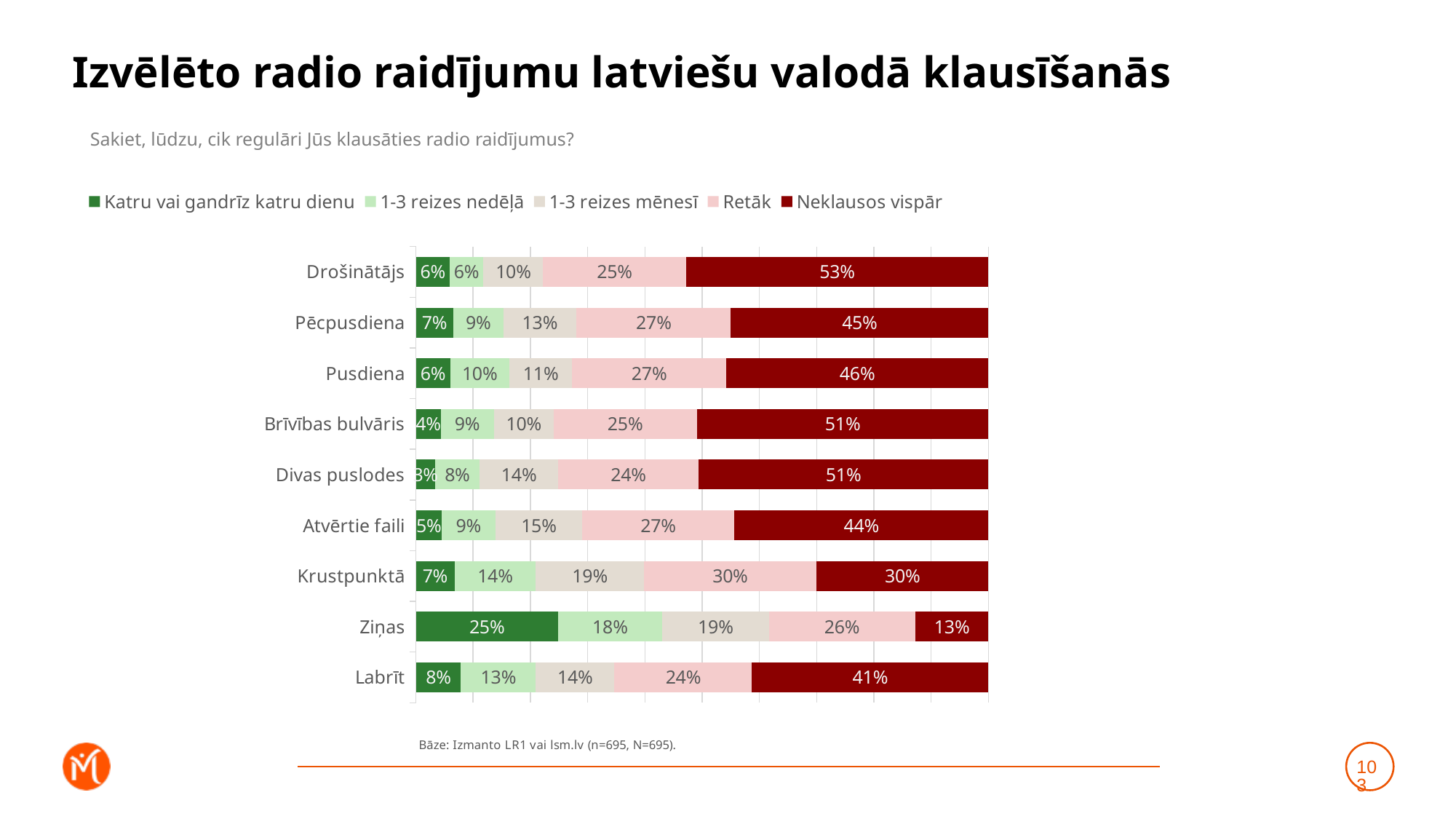
What is the difference between the 'Retāk' values for Krustpunktā and Labrīt? 6% What is the 'Katru vai gandrīz katru dienu' value for Ziņas? 25% What is the 'Neklausos vispār' value for Drošinātājs? 53% Which series is shown in dark red in the legend? Neklausos vispār What is the '1-3 reizes mēnesī' value for Krustpunktā? 19% Which is larger: the 'Katru vai gandrīz katru dienu' value for Labrīt or for Pusdiena? Labrīt Which programme has the lowest 'Neklausos vispār' value? Ziņas How many radio programmes (categories) are shown in the chart? 9 What is the total of the stacked bar for Krustpunktā? 100% What kind of chart is shown on the slide? Stacked bar chart How many series does the legend list? 5 Which programme has the highest 'Neklausos vispār' value? Drošinātājs